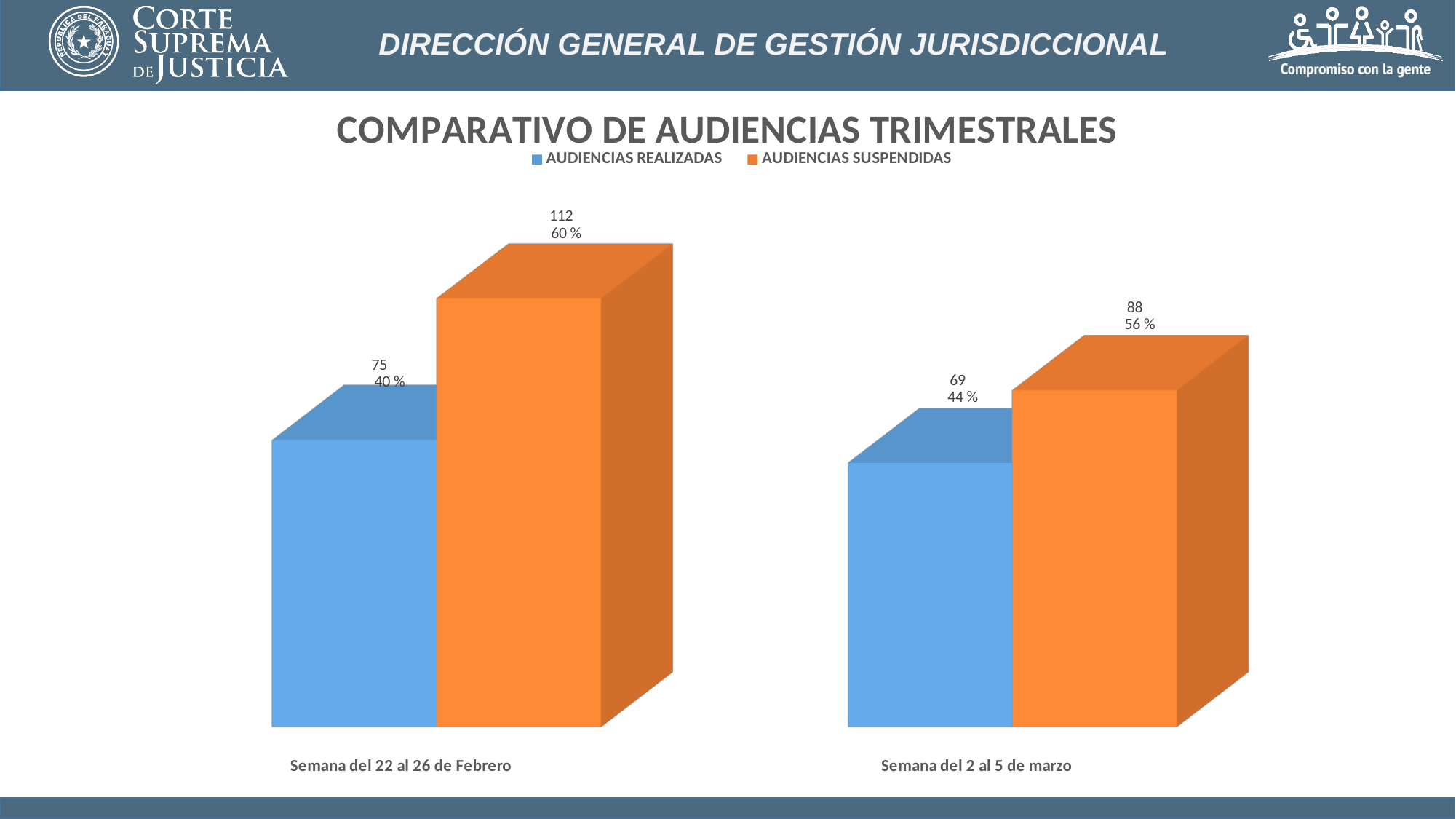
Which category has the lowest value for AUDIENCIAS REALIZADAS? Semana del 2 al 5 de marzo What is the value of AUDIENCIAS REALIZADAS for Semana del 2 al 5 de marzo? 69 What is the title of the chart? COMPARATIVO DE AUDIENCIAS TRIMESTRALES How many categories are shown on the x axis? 2 Which category has the highest value for AUDIENCIAS SUSPENDIDAS? Semana del 22 al 26 de Febrero What percentage is shown for AUDIENCIAS SUSPENDIDAS in Semana del 2 al 5 de marzo? 56 % Which is larger for Semana del 2 al 5 de marzo, AUDIENCIAS REALIZADAS or AUDIENCIAS SUSPENDIDAS? AUDIENCIAS SUSPENDIDAS What is the value of AUDIENCIAS SUSPENDIDAS for Semana del 2 al 5 de marzo? 88 What is the value of AUDIENCIAS SUSPENDIDAS for Semana del 22 al 26 de Febrero? 112 How many series does the legend list? 2 What is the value of AUDIENCIAS REALIZADAS for Semana del 22 al 26 de Febrero? 75 What is the difference between AUDIENCIAS SUSPENDIDAS and AUDIENCIAS REALIZADAS for Semana del 22 al 26 de Febrero? 37